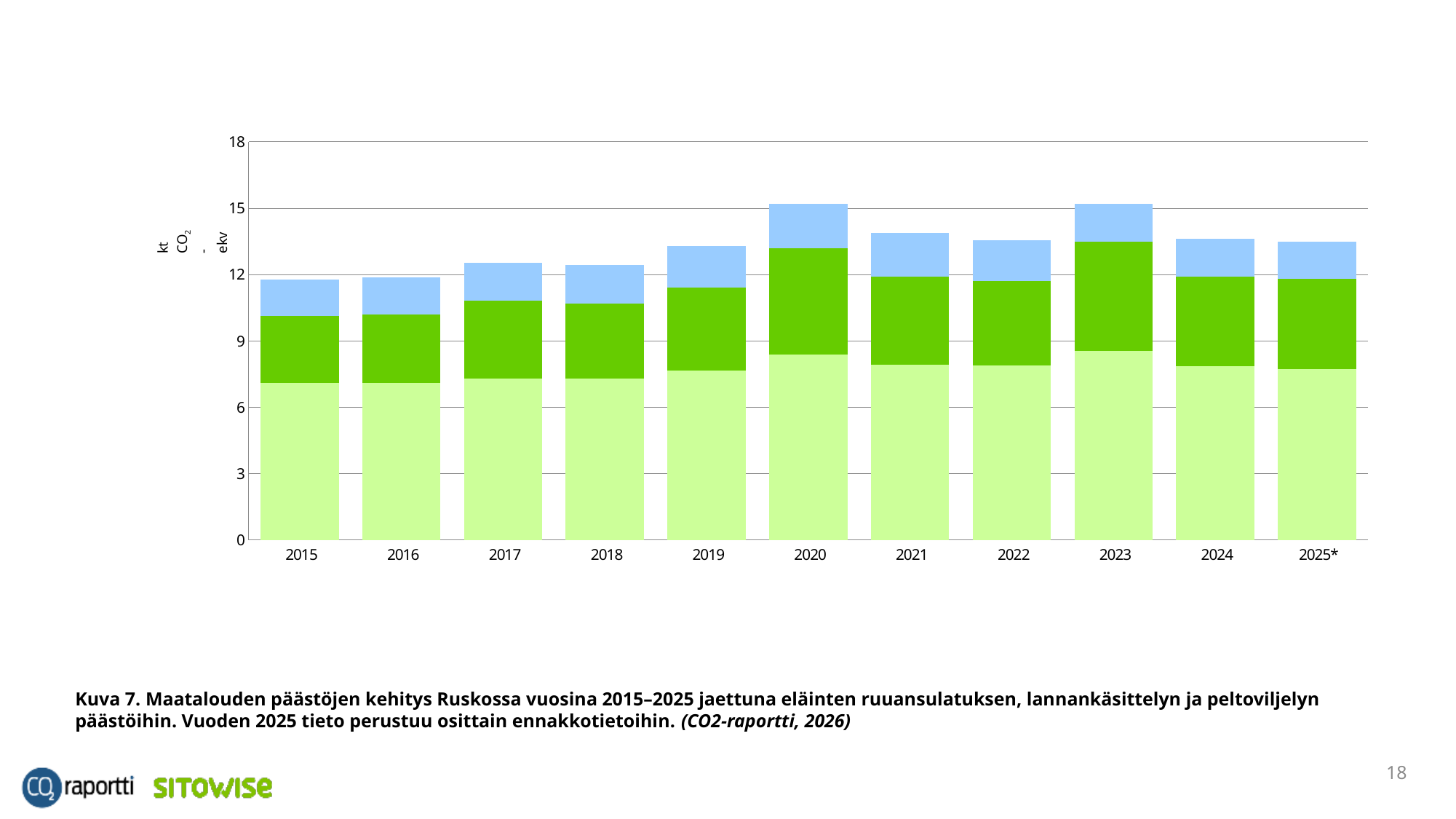
Into how many coloured segments is each bar in the chart divided? 3 Is the total value of the bar for 2015 greater or less than 12? less How many years (bars) are shown on the x axis of the chart? 11 Is the total value of the bar for 2019 greater or less than 12? greater Is the total value of the bar for 2020 greater or less than 12? greater Do the bar totals rise or fall from 2015 to 2020? rise What unit is shown on the y axis of the chart? kt CO2-ekv What kind of chart is shown on the slide? Stacked bar chart Which bar has the larger total, 2020 or 2015? 2020 Which x-axis label on the chart is marked with an asterisk? 2025* Which bar has the larger total, 2023 or 2024? 2023